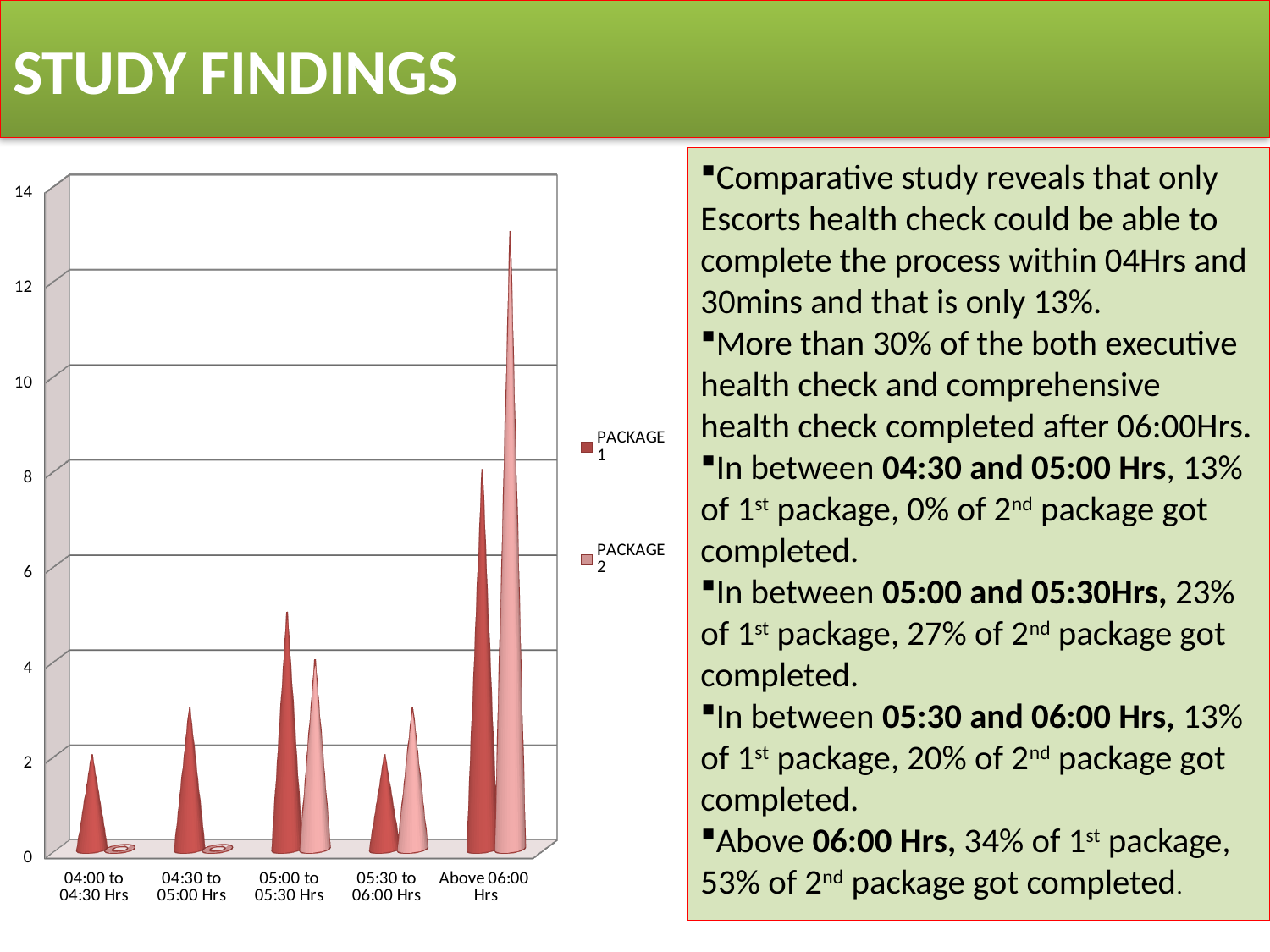
For which category is the PACKAGE 2 value highest? Above 06:00 Hrs What kind of chart is shown on the slide? bar chart Is the PACKAGE 2 value for 05:30 to 06:00 Hrs greater or less than 4? less What are the two series named in the chart's legend? PACKAGE 1 and PACKAGE 2 For which category is the PACKAGE 1 value highest? Above 06:00 Hrs Is the PACKAGE 2 value for Above 06:00 Hrs greater or less than 12? greater Is the PACKAGE 1 value for 05:00 to 05:30 Hrs greater or less than 4? greater How many time-range categories are shown on the x axis of the chart? 5 What is the highest value shown on the chart's vertical axis? 14 How many series does the chart's legend list? 2 For Above 06:00 Hrs, which series has the larger value, PACKAGE 1 or PACKAGE 2? PACKAGE 2